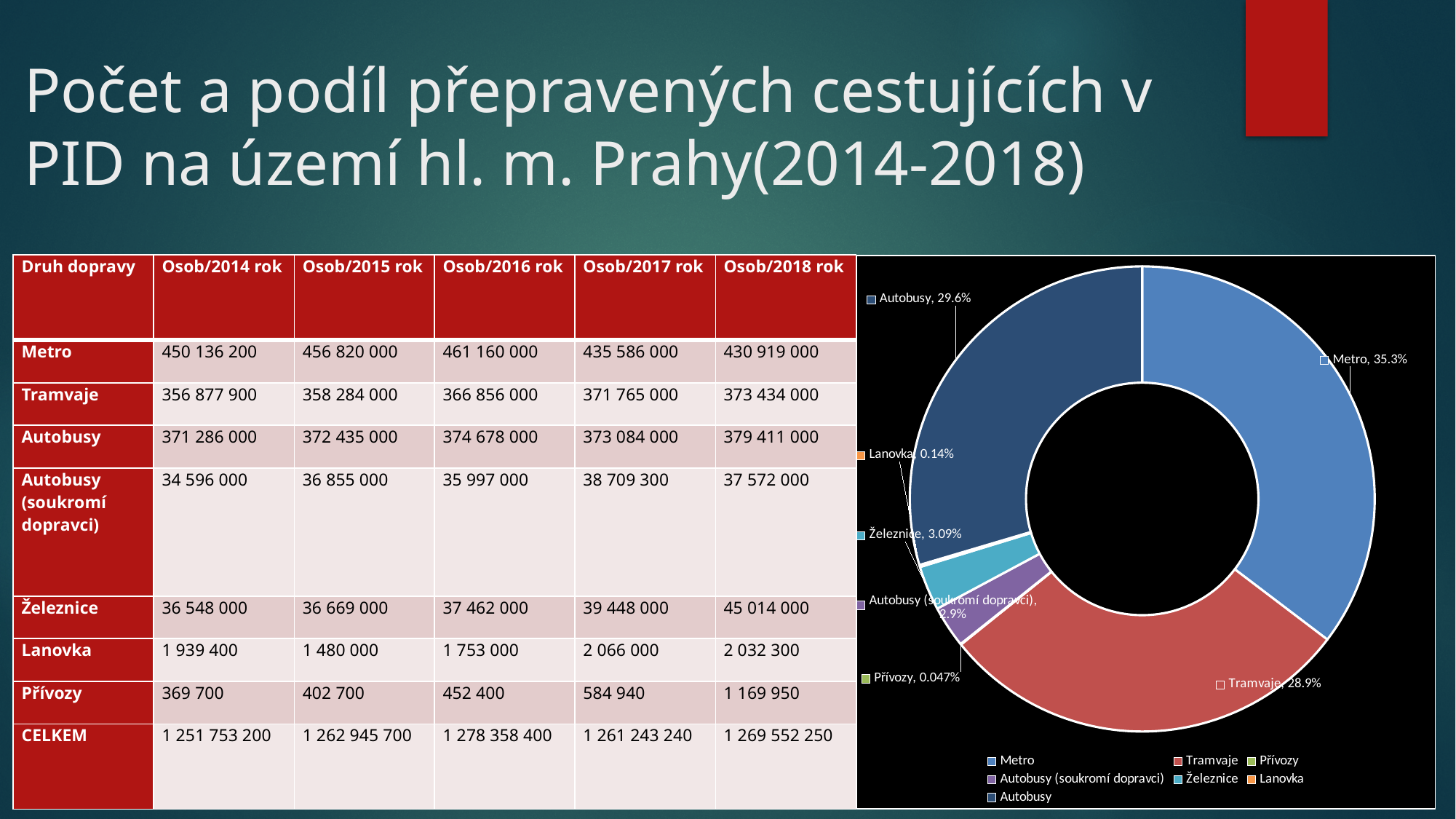
What share of the doughnut chart does Přívozy have? 0.047% What is the difference in percentage points between the Metro and Tramvaje slices in the doughnut chart? 6.4 What kind of chart is shown on the right side of the slide? Doughnut (pie) chart Which category has the largest slice in the doughnut chart? Metro What share of the doughnut chart does Metro have? 35.3% What share of the doughnut chart does Lanovka have? 0.14% How many categories does the legend of the doughnut chart list? 7 In the doughnut chart, which slice is larger: Autobusy or Tramvaje? Autobusy Which category has the smallest slice in the doughnut chart? Přívozy